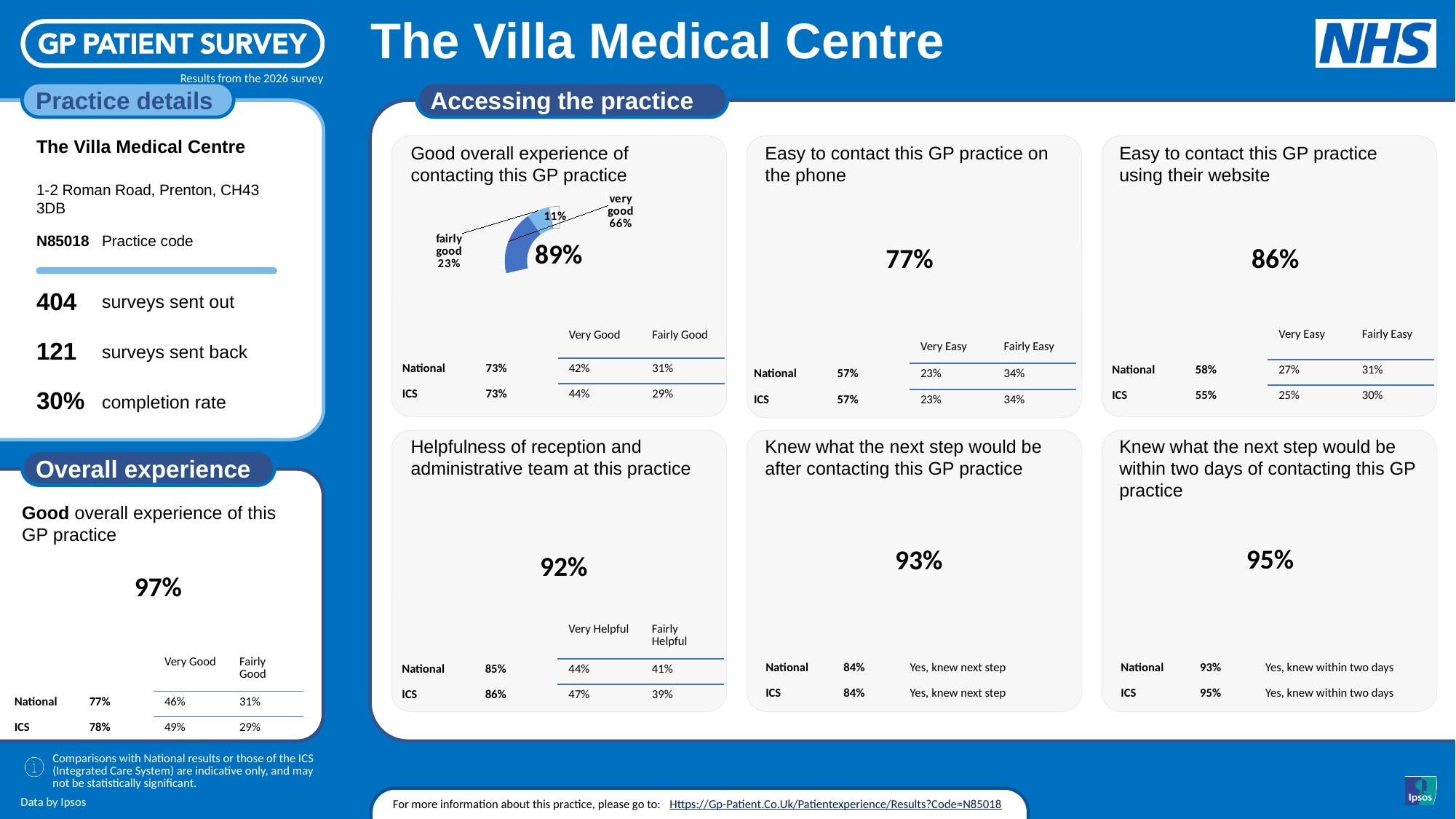
How many slices does the 'Good overall experience of contacting this GP practice' chart have? 3 In the 'Good overall experience of contacting this GP practice' chart, which slice is the smallest? The 11% slice What kind of chart is used in the 'Good overall experience of contacting this GP practice' panel? Doughnut (pie) chart What value is printed in the centre of the 'Good overall experience of contacting this GP practice' chart? 89% In the 'Good overall experience of contacting this GP practice' chart, what percentage is shown for 'fairly good'? 23% In the 'Good overall experience of contacting this GP practice' chart, what percentage is shown on the small light-blue slice? 11% In the 'Good overall experience of contacting this GP practice' chart, what is the difference in percentage points between 'very good' and 'fairly good'? 43 percentage points In the 'Good overall experience of contacting this GP practice' chart, is the value for 'very good' greater or less than 50%? greater In the 'Good overall experience of contacting this GP practice' chart, what percentage is shown for 'very good'? 66% In the 'Good overall experience of contacting this GP practice' chart, what is the combined percentage of 'very good' and 'fairly good'? 89% In the 'Good overall experience of contacting this GP practice' chart, which is larger, 'very good' or 'fairly good'? very good In the 'Good overall experience of contacting this GP practice' chart, which labelled slice is the largest? very good